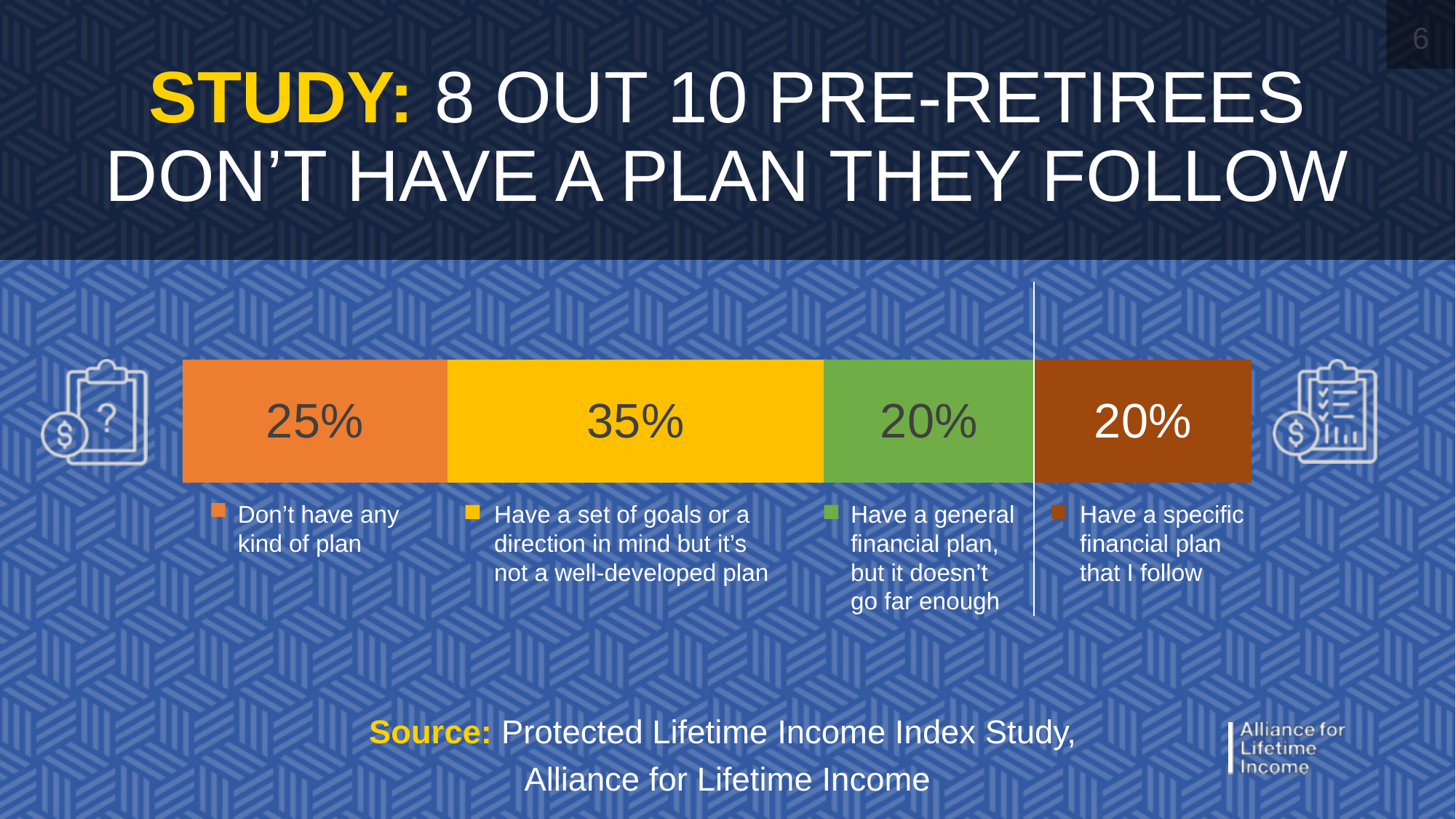
How many categories are shown in the stacked bar? 4 What percentage have a general financial plan, but it doesn't go far enough? 20% What is the total of all segments in the stacked bar? 100% What kind of chart is shown on the slide? Stacked bar chart What percentage have a specific financial plan that they follow? 20% What is the difference between the share that have a set of goals but not a well-developed plan and the share that don't have any kind of plan? 10 percentage points What percentage have a set of goals or a direction in mind but not a well-developed plan? 35% Which is larger: the share that don't have any kind of plan or the share that have a specific financial plan they follow? Don't have any kind of plan What is the combined share of the three categories to the left of the vertical divider line? 80% Which category has the largest share? Have a set of goals or a direction in mind but it's not a well-developed plan What percentage of pre-retirees don't have any kind of plan? 25% What colour is the segment for 'Have a general financial plan, but it doesn't go far enough'? Green